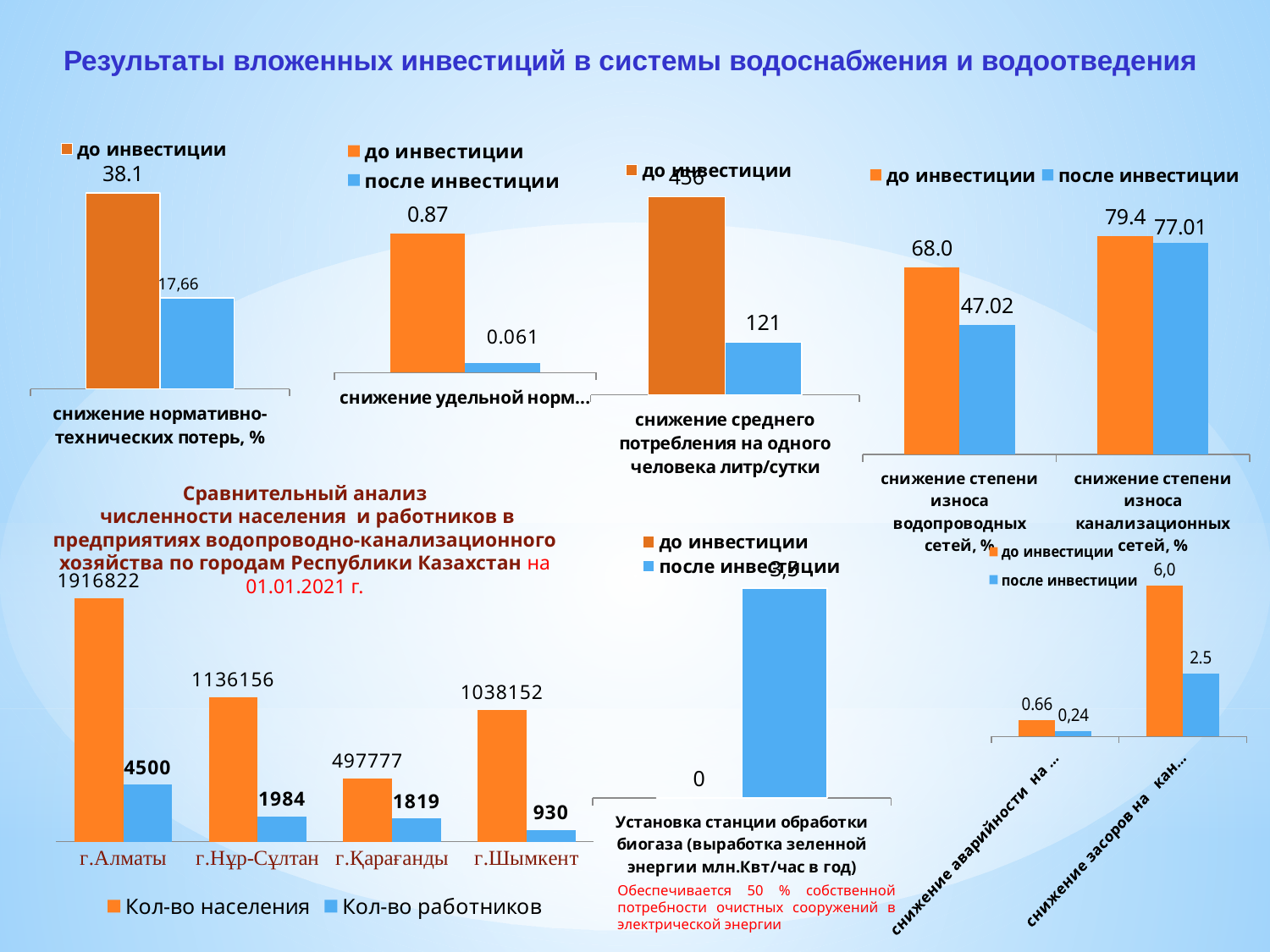
In the chart titled 'снижение нормативно-технических потерь, %', what is the value for 'после инвестиции'? 17,66 In the chart 'Сравнительный анализ численности населения и работников...', which city has the highest 'Кол-во населения'? г.Алматы In the chart with categories 'снижение степени износа водопроводных сетей, %' and 'снижение степени износа канализационных сетей, %', what is the difference between the 'до инвестиции' and 'после инвестиции' values for канализационных сетей? 2.39 In the chart 'Сравнительный анализ численности населения и работников...', which city has the lowest 'Кол-во работников'? г.Шымкент In the chart titled 'снижение нормативно-технических потерь, %', what is the value for 'до инвестиции'? 38.1 In the chart titled 'снижение среднего потребления на одного человека литр/сутки', what is the value for 'после инвестиции'? 121 In the bottom-right chart, what is the 'до инвестиции' value for 'снижение засоров на кан...'? 6,0 How many cities are shown in the chart 'Сравнительный анализ численности населения и работников...'? 4 What type of chart is the chart 'Сравнительный анализ численности населения и работников...'? bar chart In the chart titled 'снижение удельной норм...', what is the value for 'после инвестиции'? 0.061 In the chart with categories 'снижение степени износа водопроводных сетей, %' and 'снижение степени износа канализационных сетей, %', what is the 'после инвестиции' value for водопроводных сетей? 47.02 In the chart 'Сравнительный анализ численности населения и работников...', what is the 'Кол-во работников' value for г.Қарағанды? 1819